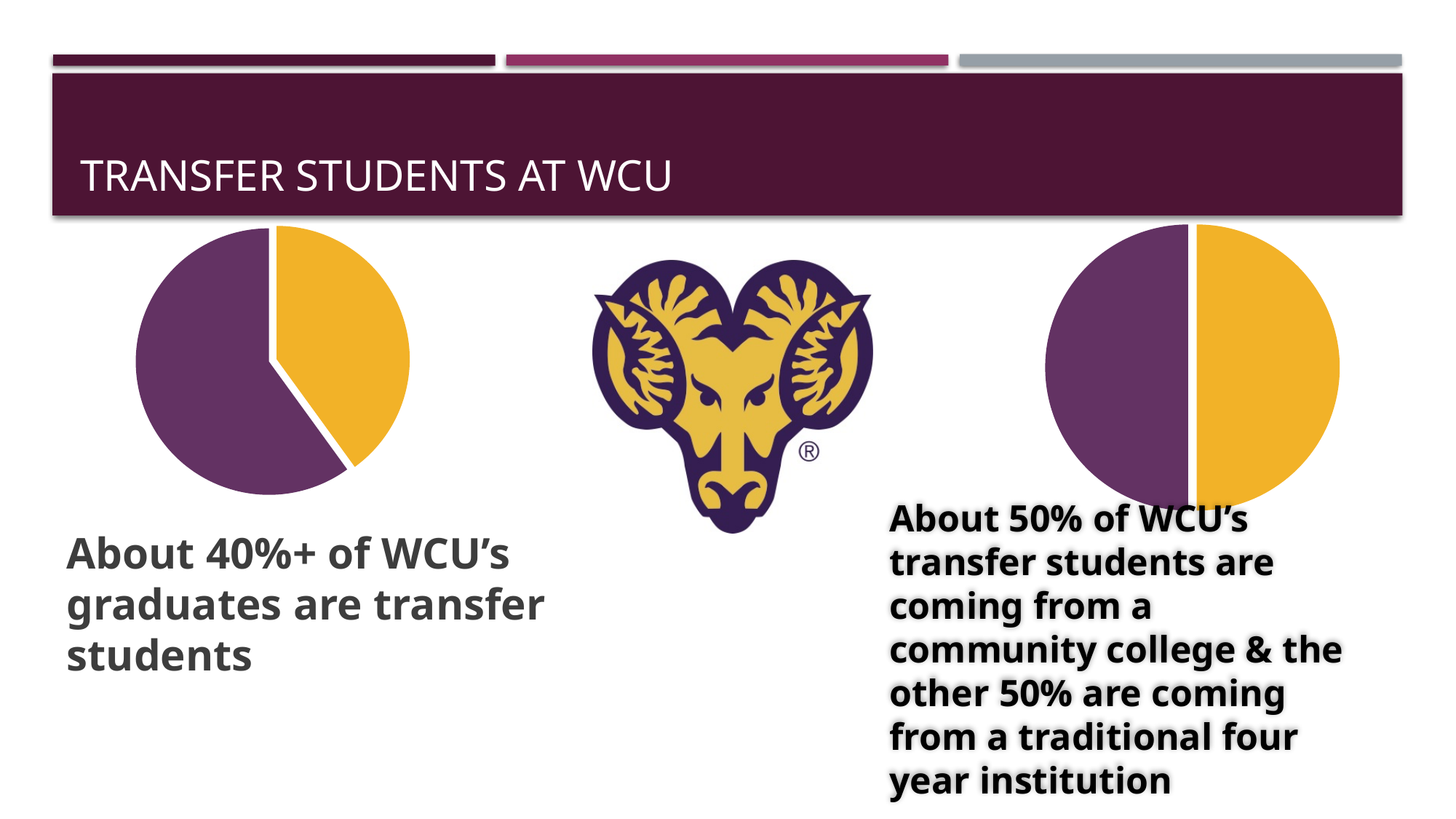
What kind of chart is the chart on the right of the slide? pie chart In the left pie chart, does the yellow slice take up more or less than half of the pie? less In the left pie chart, which colour slice is the largest? purple In the left pie chart, which colour slice is the smallest? yellow How many pie charts are shown on the slide? 2 What two colours are used for the slices in the pie charts? purple and yellow How many slices does the left pie chart have? 2 In the left pie chart, which slice is larger, the purple one or the yellow one? purple What kind of chart is the chart on the left of the slide? pie chart How many slices does the right pie chart have? 2